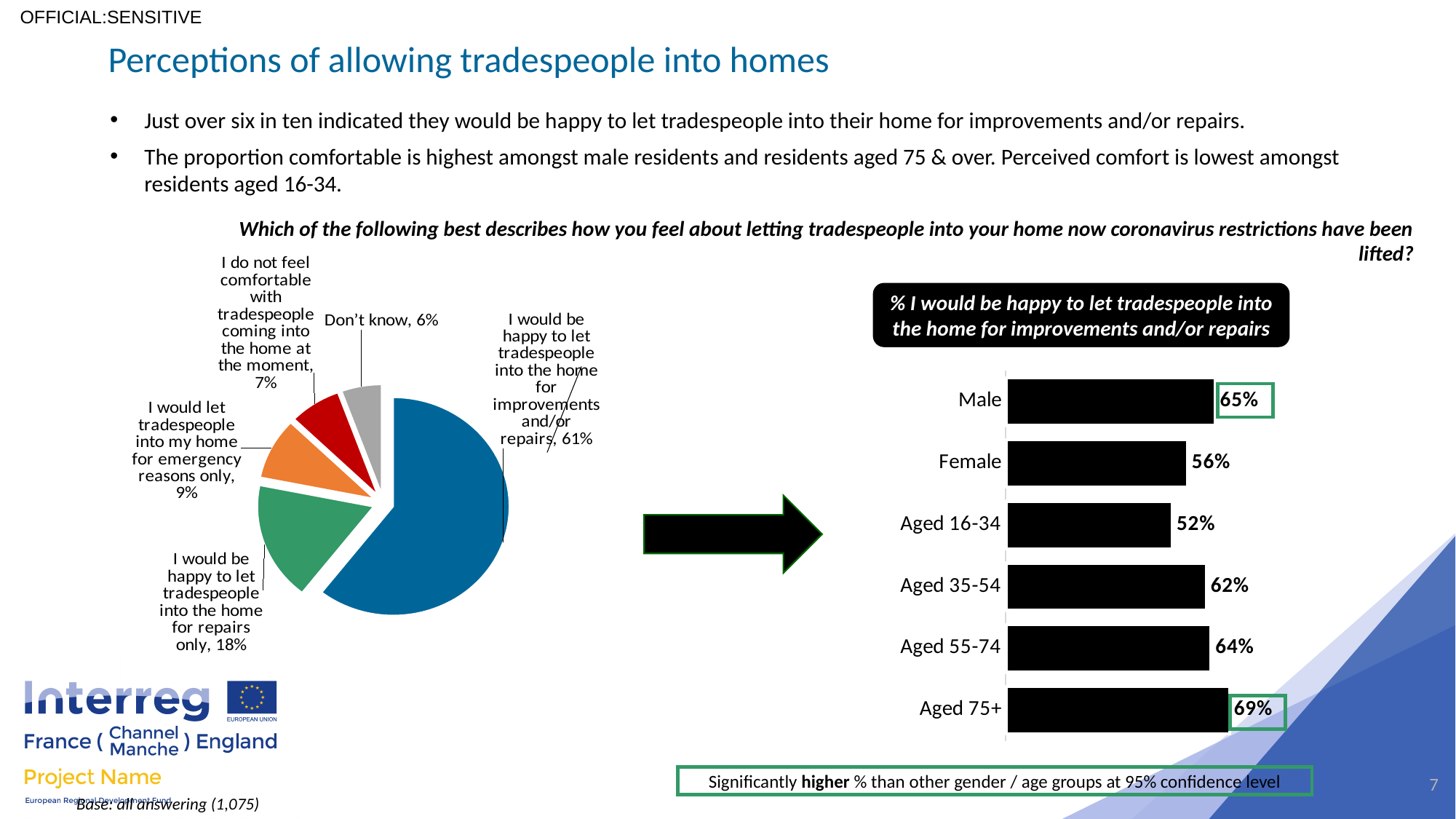
In the bar chart on the right, what percentage of male residents would be happy to let tradespeople into the home for improvements and/or repairs? 65% In the bar chart on the right, which group has the highest value? Aged 75+ In the bar chart on the right, what is the value for Aged 16-34? 52% In the pie chart on the left, what share of respondents said they would be happy to let tradespeople into the home for repairs only? 18% In the pie chart on the left, how many slices are there? 5 What type of chart is shown on the right side of the slide? Bar chart In the bar chart on the right, which group has the lowest value? Aged 16-34 In the pie chart on the left, what share of respondents answered 'Don't know'? 6% In the bar chart on the right, which is larger, the value for Aged 35-54 or Aged 55-74? Aged 55-74 In the pie chart on the left, what share of respondents said they would be happy to let tradespeople into the home for improvements and/or repairs? 61% In the bar chart on the right, what is the difference between the Male and Female values? 9 percentage points In the pie chart on the left, which response has the smallest share? Don't know